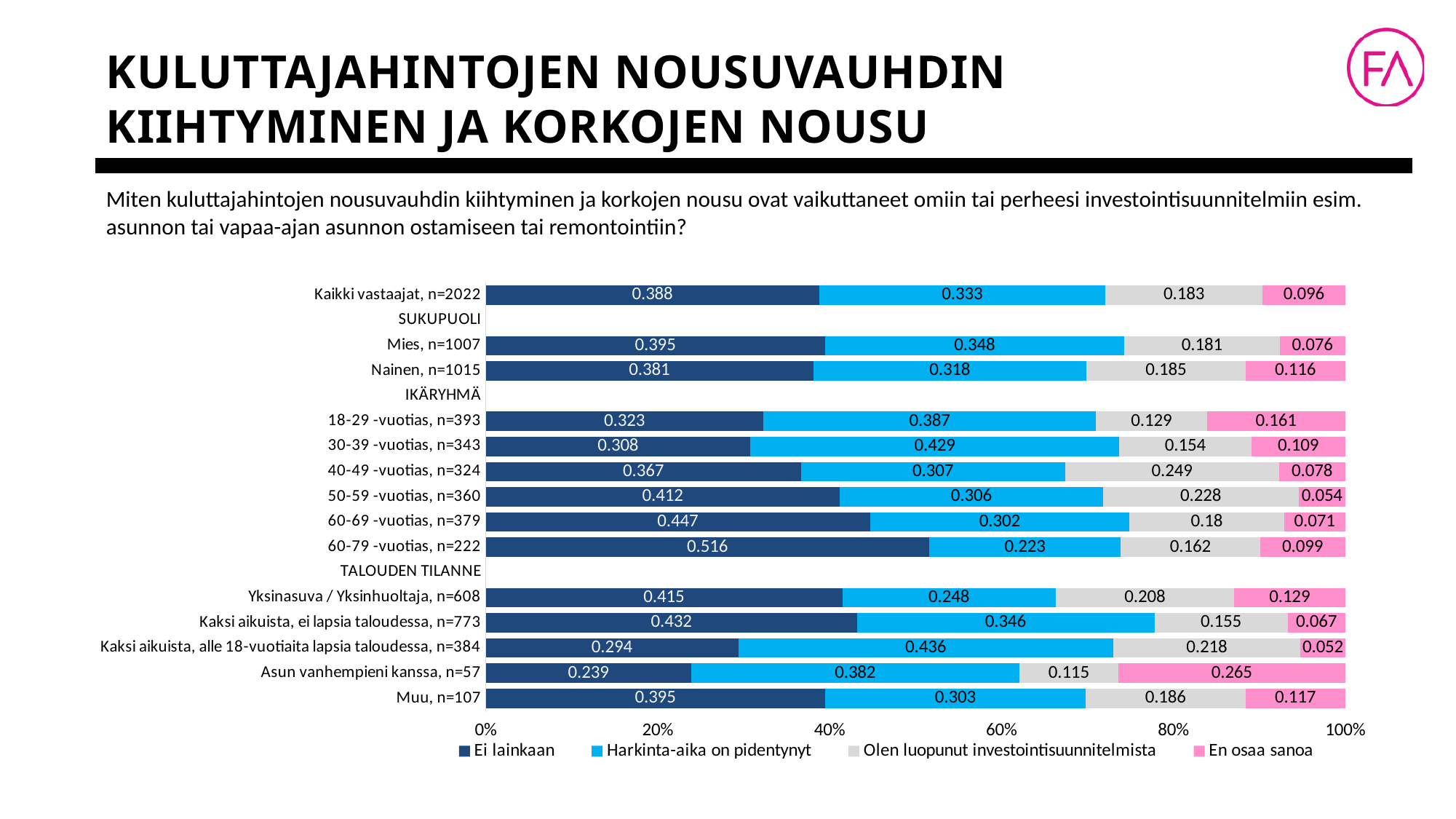
Which group has the lowest 'Ei lainkaan' value? Asun vanhempieni kanssa, n=57 What is the difference between the 'Ei lainkaan' values for Mies, n=1007 and Nainen, n=1015? 0.014 Is the 'Ei lainkaan' value for 60-79 -vuotias, n=222 greater or less than 40%? greater How many series does the legend list? 4 What is the 'Harkinta-aika on pidentynyt' value for 30-39 -vuotias, n=343? 0.429 What is the 'En osaa sanoa' value for Asun vanhempieni kanssa, n=57? 0.265 What is the 'Ei lainkaan' value for Kaikki vastaajat, n=2022? 0.388 What kind of chart is shown on the slide? Stacked bar chart How many respondent groups (bars) are plotted in the chart? 14 What is the 'Olen luopunut investointisuunnitelmista' value for 40-49 -vuotias, n=324? 0.249 Which is larger, the 'En osaa sanoa' value for 18-29 -vuotias, n=393 or for 60-69 -vuotias, n=379? 18-29 -vuotias, n=393 Which group has the highest 'Ei lainkaan' value? 60-79 -vuotias, n=222